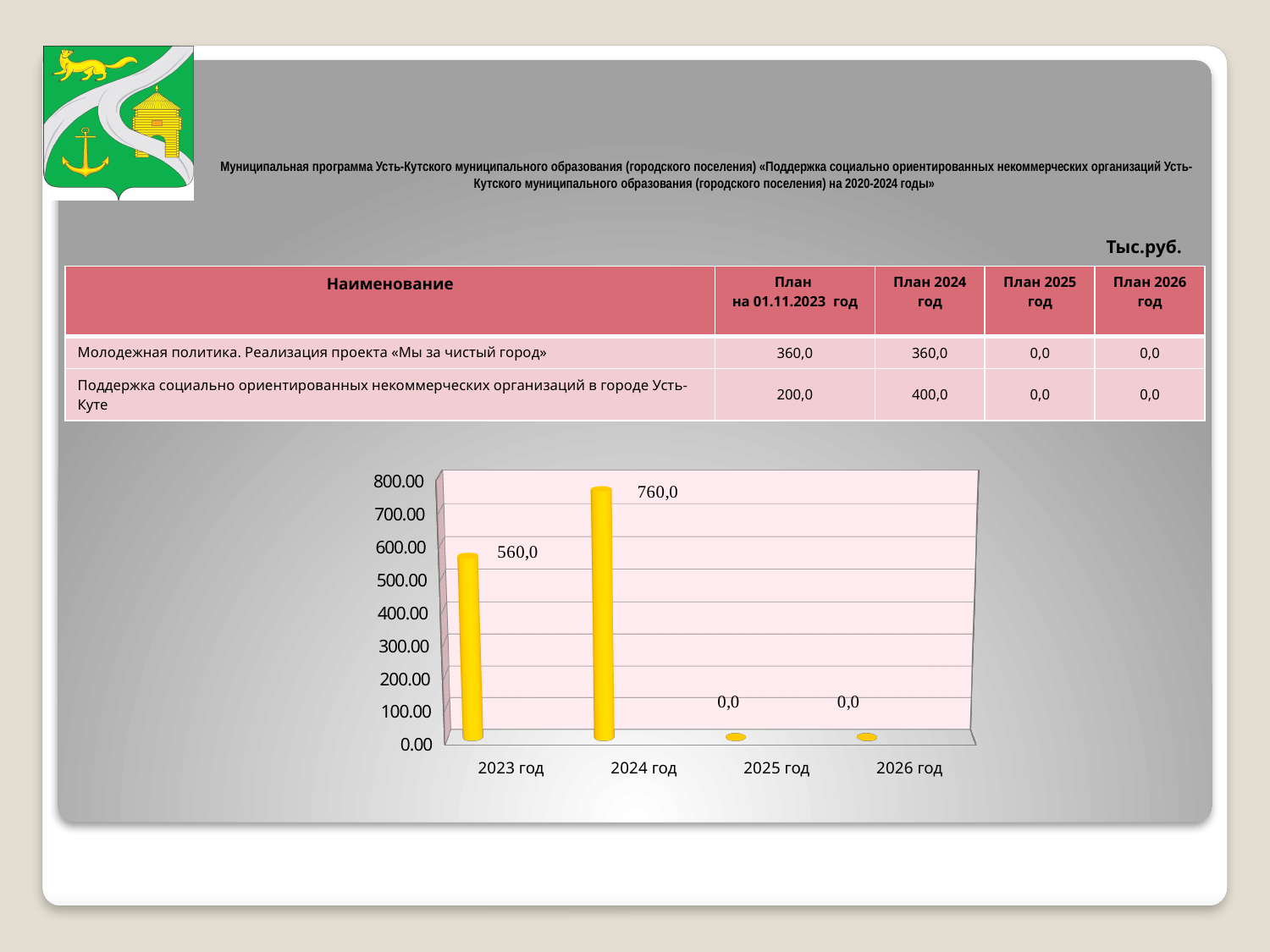
What is the value shown for 2024 год on the chart? 760,0 What is the value shown for 2023 год on the chart? 560,0 Which is larger on the chart, the value for 2023 год or the value for 2024 год? 2024 год What is the value shown for 2025 год on the chart? 0,0 What colour are the bars on the chart? yellow How many categories are shown on the x axis of the chart? 4 Does the value rise or fall from 2023 год to 2024 год on the chart? rise What kind of chart is shown on the slide? bar chart Is the value for 2024 год greater or less than 800.00? less What is the difference between the values for 2024 год and 2023 год on the chart? 200,0 Which year has the highest value on the chart? 2024 год Is the value for 2023 год greater or less than 500.00? greater